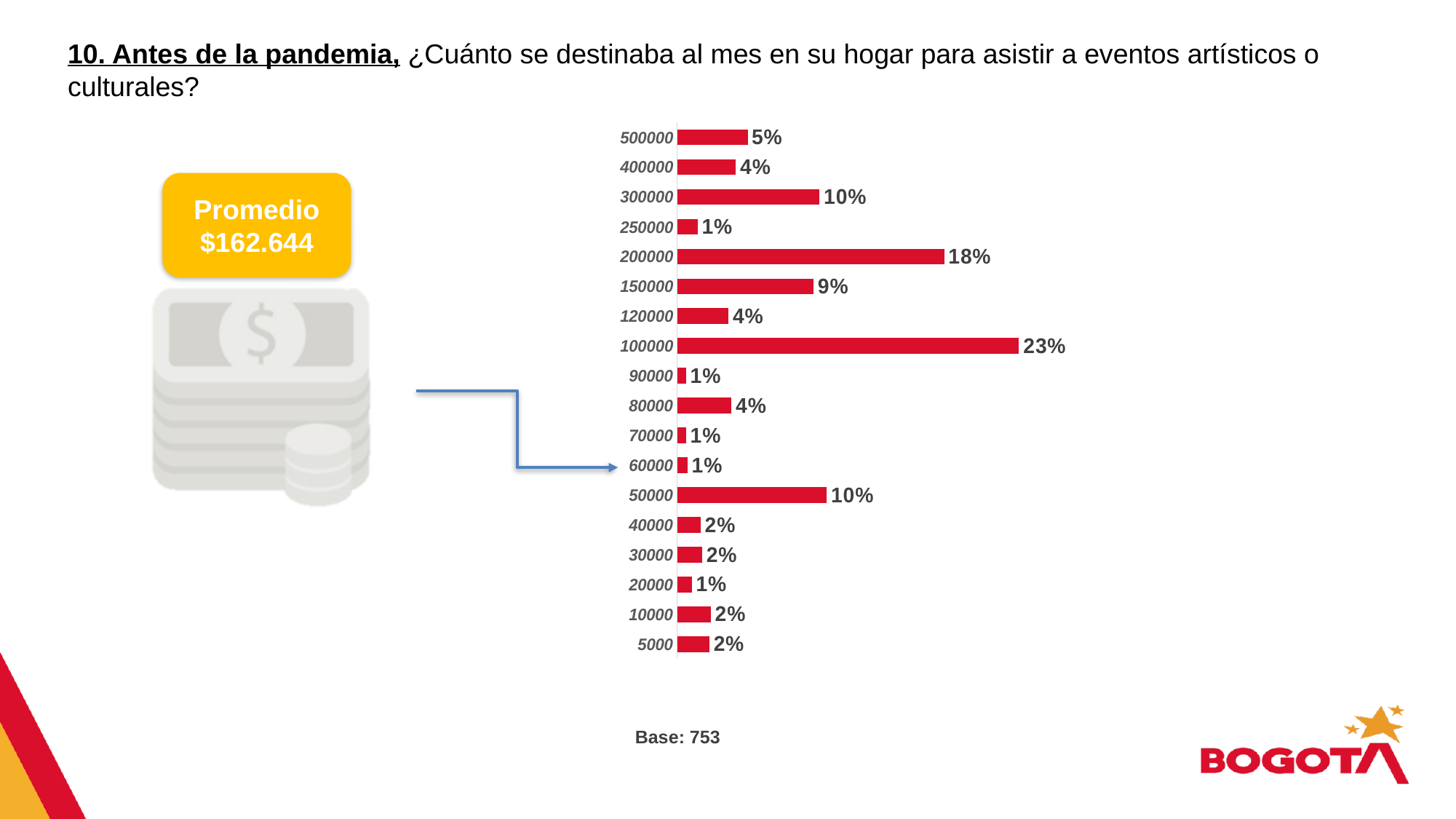
Which spending amount has the highest percentage of households? 100000 Which has a larger value, the 150000 category or the 120000 category? 150000 What percentage of households spent 100000 per month on artistic or cultural events before the pandemic? 23% Which has a larger value, the 500000 category or the 400000 category? 500000 What average monthly amount (Promedio) is shown on the slide? $162.644 How many spending categories are shown in the chart? 18 What is the difference in percentage points between the 100000 category and the 200000 category? 5 What percentage is shown for the 50000 category? 10% What is the difference in percentage points between the 300000 category and the 250000 category? 9 What type of chart is used on this slide? Bar chart What is the value for the 150000 category? 9% What is the value shown for the 200000 category? 18%